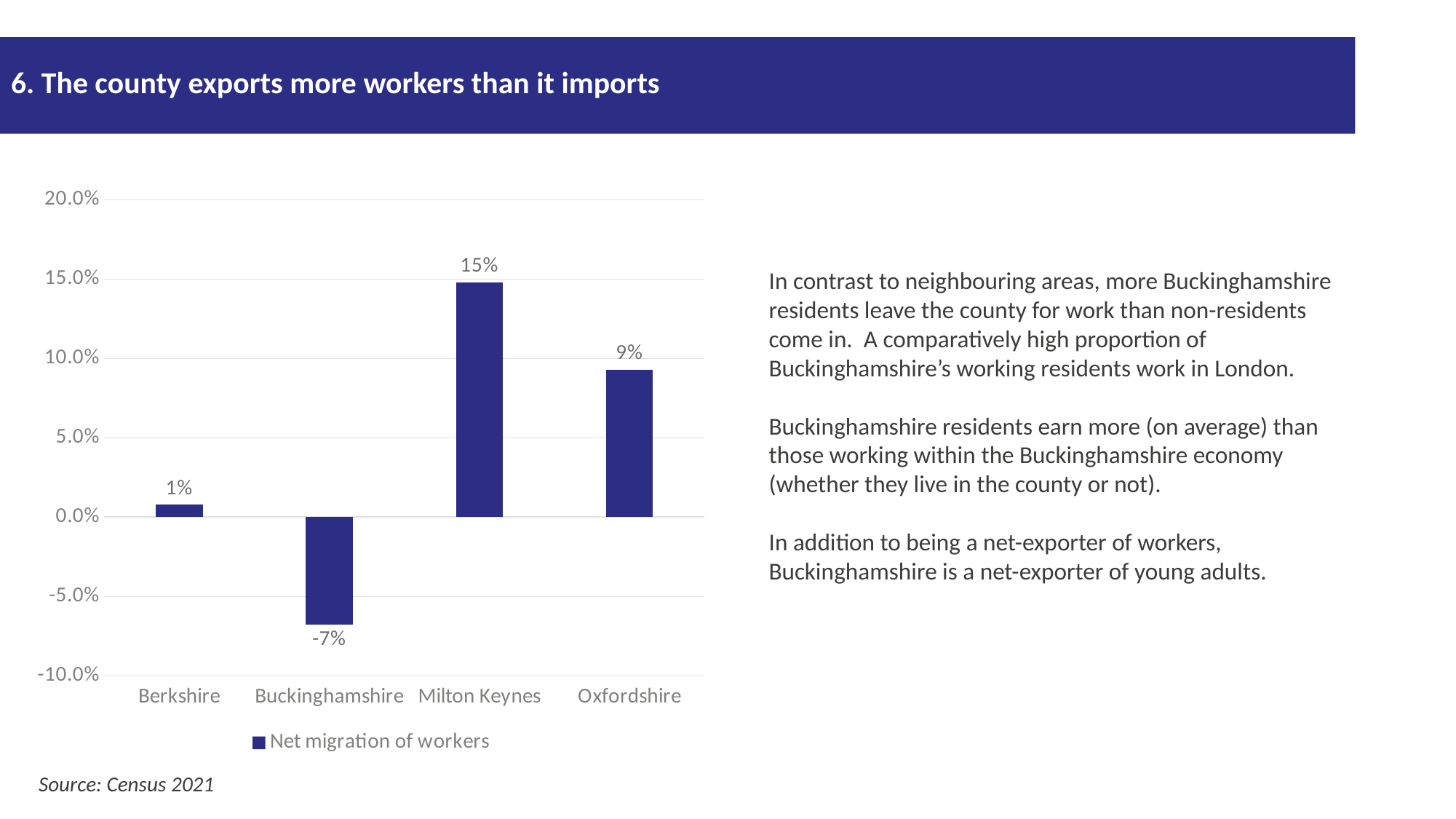
How many areas are shown on the chart? 4 Which has a larger net migration of workers, Oxfordshire or Berkshire? Oxfordshire Is the value for Buckinghamshire greater or less than -5.0%? less Which area has the highest net migration of workers? Milton Keynes What is the net migration of workers for Oxfordshire? 9% What series does the legend list? Net migration of workers Which area has the lowest net migration of workers? Buckinghamshire What is the net migration of workers for Buckinghamshire? -7% What is the net migration of workers for Berkshire? 1% What kind of chart is shown on the slide? Bar chart What is the net migration of workers for Milton Keynes? 15% What is the difference between the net migration of workers for Milton Keynes and Oxfordshire? 6%